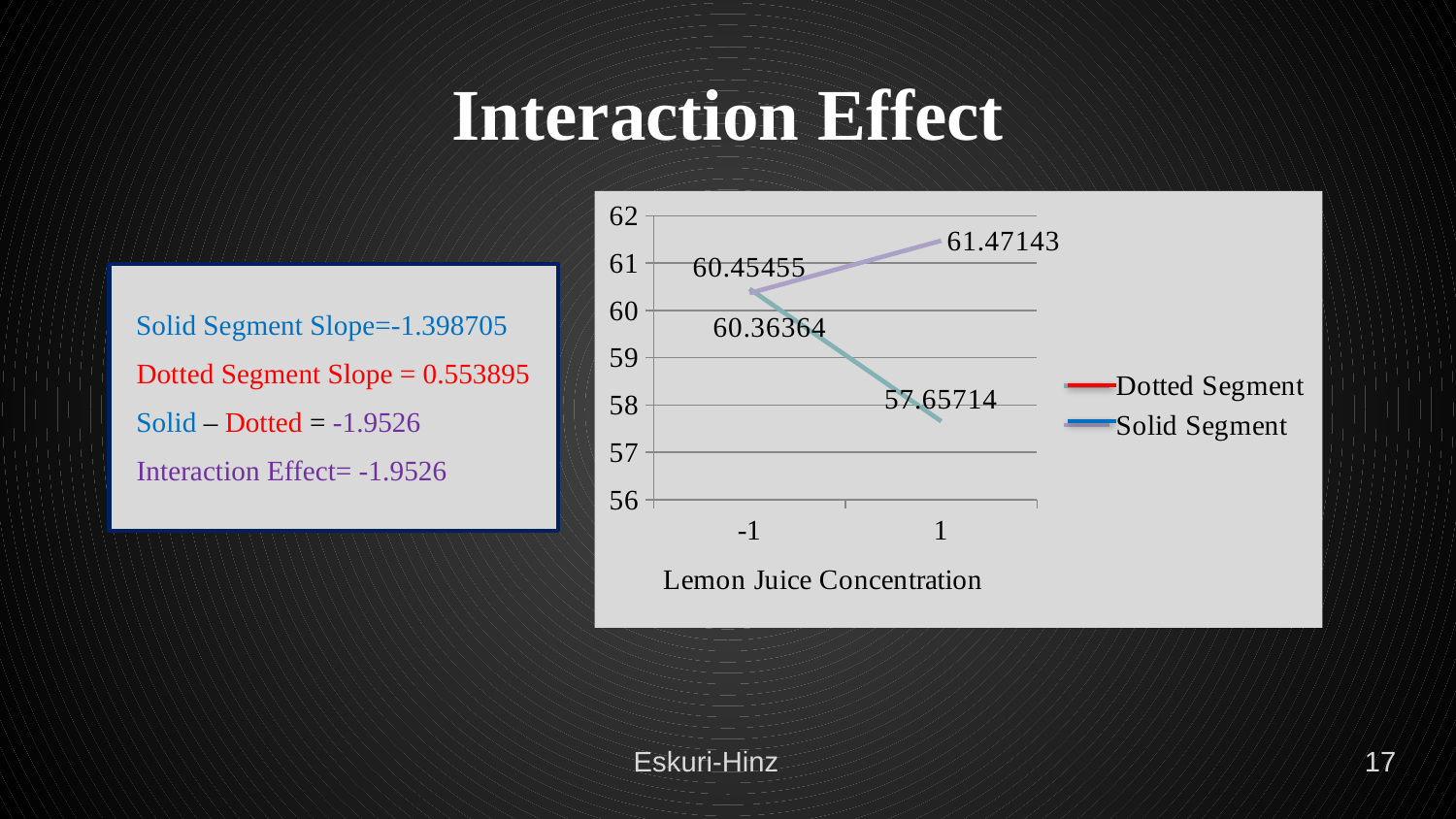
How many series does the chart legend list? 2 What is the highest value labeled on the chart? 61.47143 What is the lowest value labeled on the chart? 57.65714 What is the difference between the Dotted Segment and Solid Segment values at Lemon Juice Concentration 1? 3.81429 How many points are on the x axis of the chart? 2 What is the title of the x axis of the chart? Lemon Juice Concentration What type of chart is shown on the slide? line chart